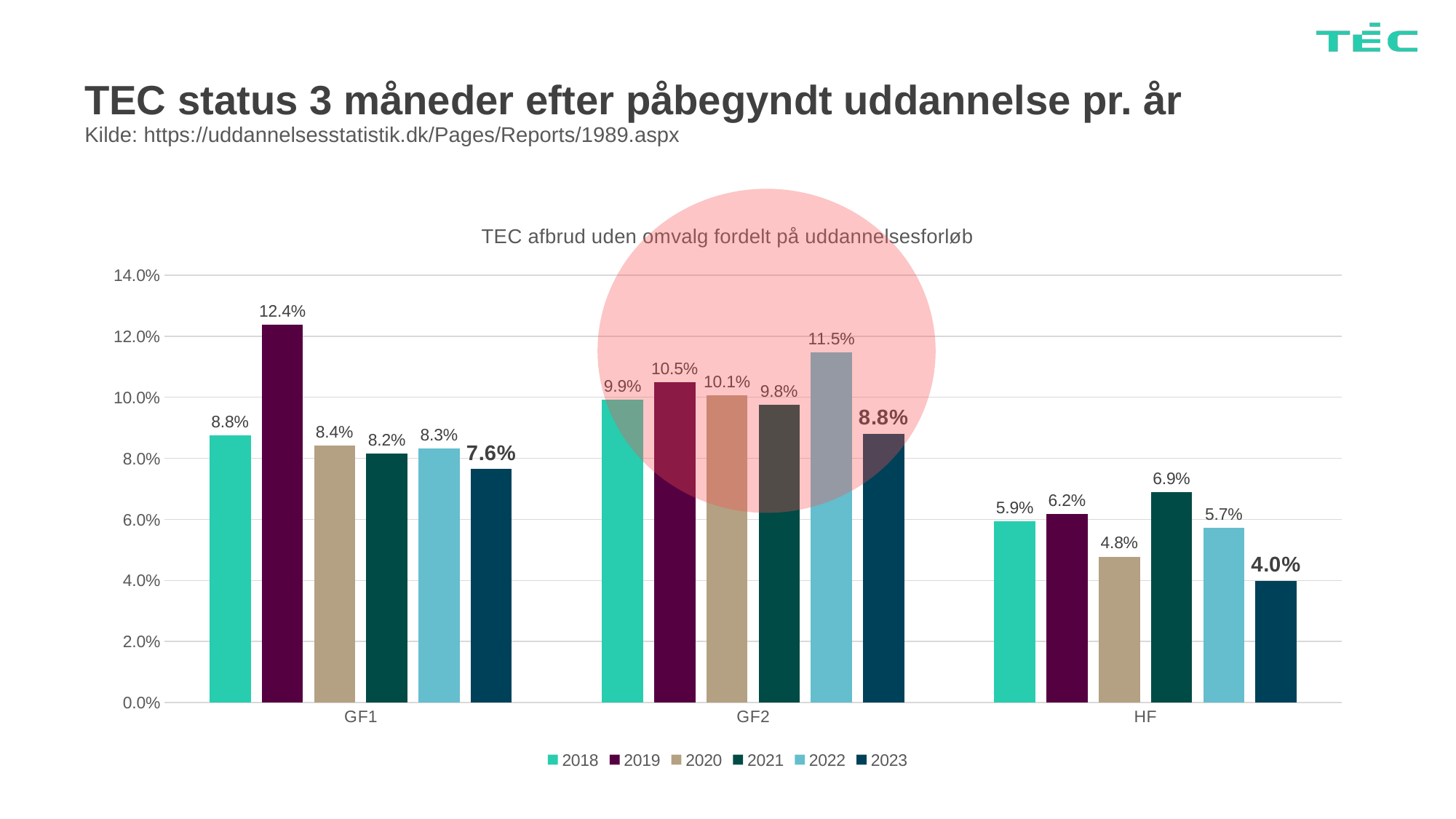
What is the title of the chart? TEC afbrud uden omvalg fordelt på uddannelsesforløb Which year has the highest value in the GF2 category? 2022 Which is larger: the 2021 value for HF or the 2022 value for HF? 2021 What is the value for 2019 in the GF1 category? 12.4% What is the value for 2022 in the GF2 category? 11.5% What is the value for 2023 in the HF category? 4.0% Which year has the lowest value in the HF category? 2023 What type of chart is shown on the slide? Bar chart How many series does the legend list? 6 How many categories are shown on the x axis? 3 Is the value for 2020 in the HF category greater or less than 6.0%? less What is the difference between the 2019 and 2023 values in the GF1 category? 4.8%